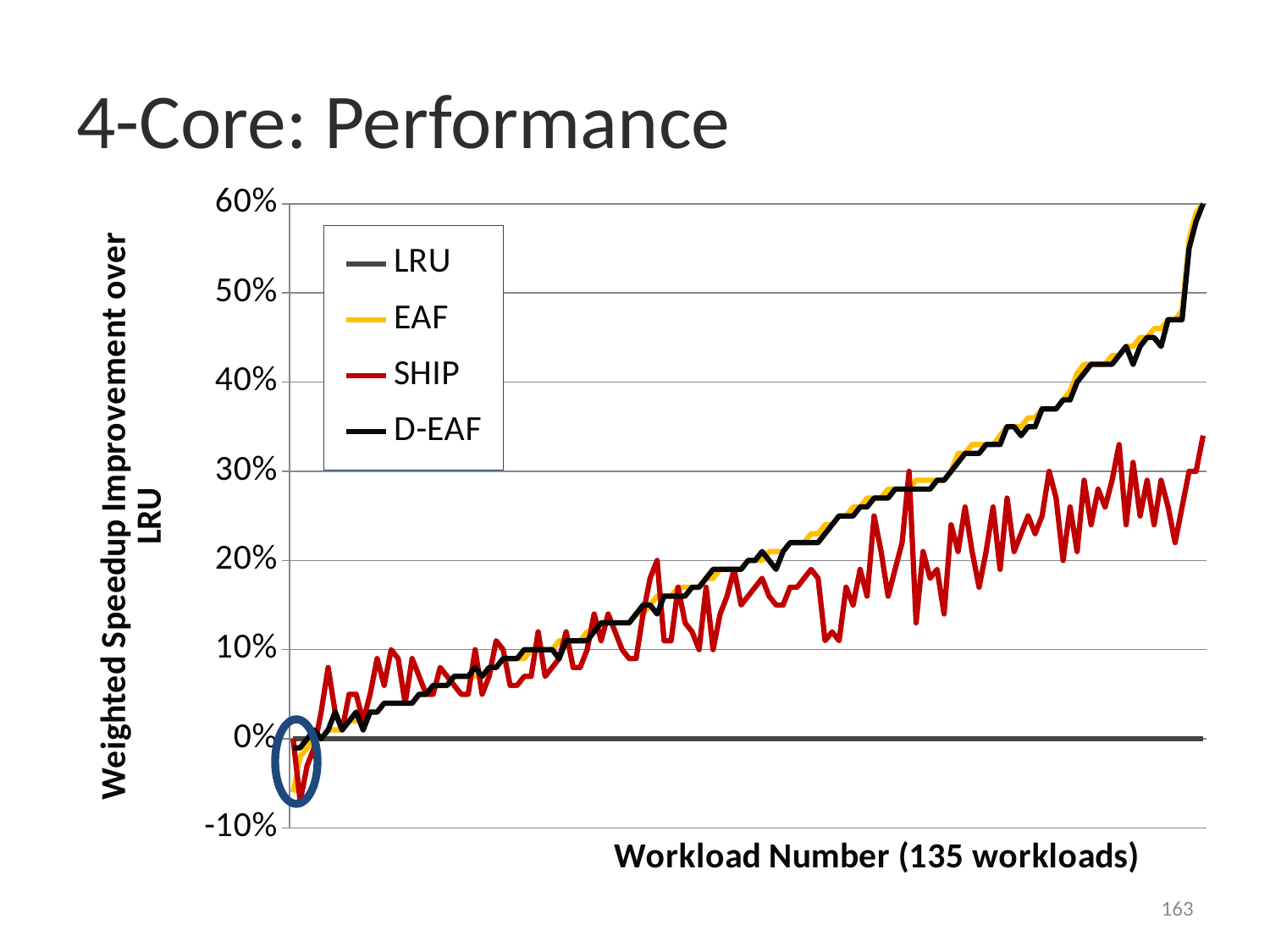
At the rightmost workload, which series has the larger value, SHIP or D-EAF? D-EAF Which series has the lowest value at the rightmost workload? LRU How many workloads are plotted along the x axis according to the axis label? 135 What is the title of the slide containing the chart? 4-Core: Performance How many series does the legend list? 4 What is the highest value shown on the y axis? 60% Is the D-EAF value at the rightmost workload greater or less than 50%? greater What value does the LRU line hold across all workloads? 0% Which series are listed in the legend? LRU, EAF, SHIP, D-EAF Is the SHIP value at the rightmost workload greater or less than 40%? less What kind of chart is shown on the slide? line chart Do the D-EAF values rise or fall as the workload number increases along the x axis? rise